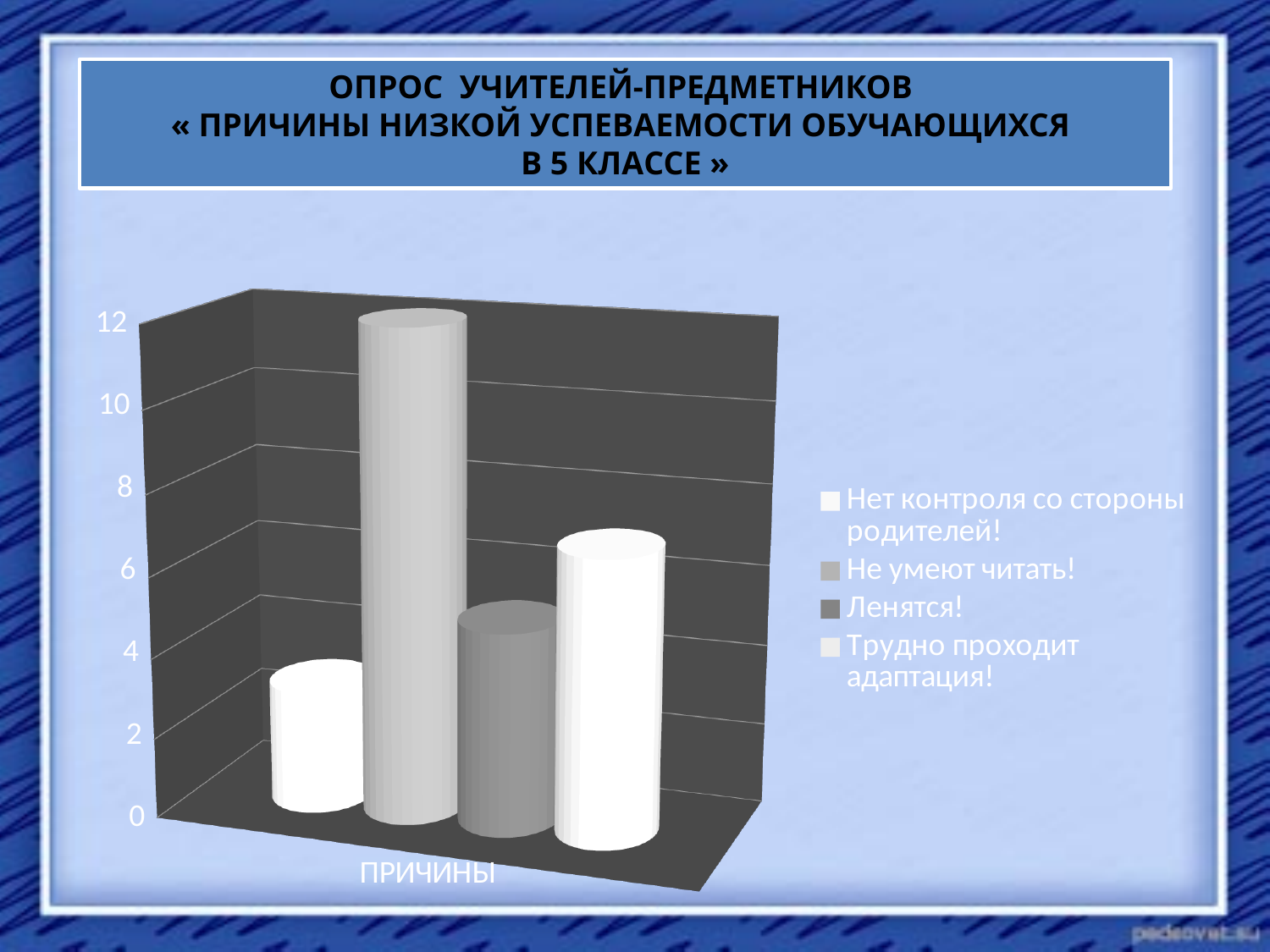
Which series has the highest value? Не умеют читать! What kind of chart is shown on the slide? bar chart How many series does the legend list? 4 Which series has the lowest value? Нет контроля со стороны родителей! Is the value for "Нет контроля со стороны родителей!" greater or less than 6? less What is the label on the category axis of the chart? ПРИЧИНЫ Which is larger: the value for "Трудно проходит адаптация!" or the value for "Ленятся!"? Трудно проходит адаптация! How many categories are shown on the x axis? 1 Is the value for "Трудно проходит адаптация!" greater or less than 4? greater Which is larger: the value for "Ленятся!" or the value for "Нет контроля со стороны родителей!"? Ленятся! Is the value for "Ленятся!" greater or less than 8? less